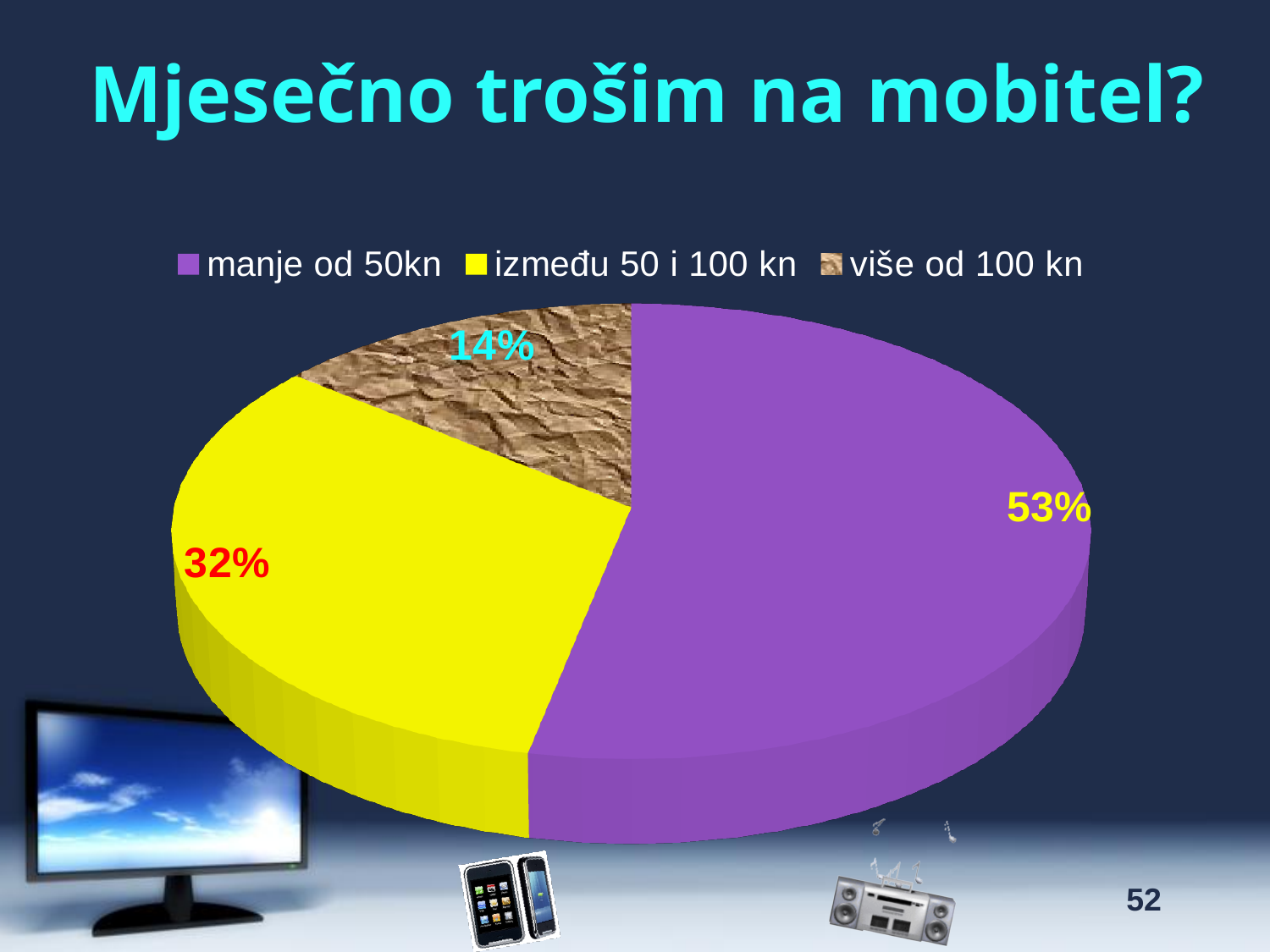
Which is larger: the slice for "između 50 i 100 kn" or the slice for "više od 100 kn"? između 50 i 100 kn What colour is the slice for "između 50 i 100 kn"? yellow What share of the pie does "više od 100 kn" take? 14% What is the title of the slide containing the chart? Mjesečno trošim na mobitel? Which category has the smallest slice of the pie? više od 100 kn How many categories does the pie chart have? 3 Which category has the largest slice of the pie? manje od 50kn What is the difference in percentage points between "manje od 50kn" and "između 50 i 100 kn"? 21 What is the difference in percentage points between "između 50 i 100 kn" and "više od 100 kn"? 18 What share of the pie does "manje od 50kn" take? 53% What share of the pie does "između 50 i 100 kn" take? 32% What kind of chart is shown on the slide? pie chart